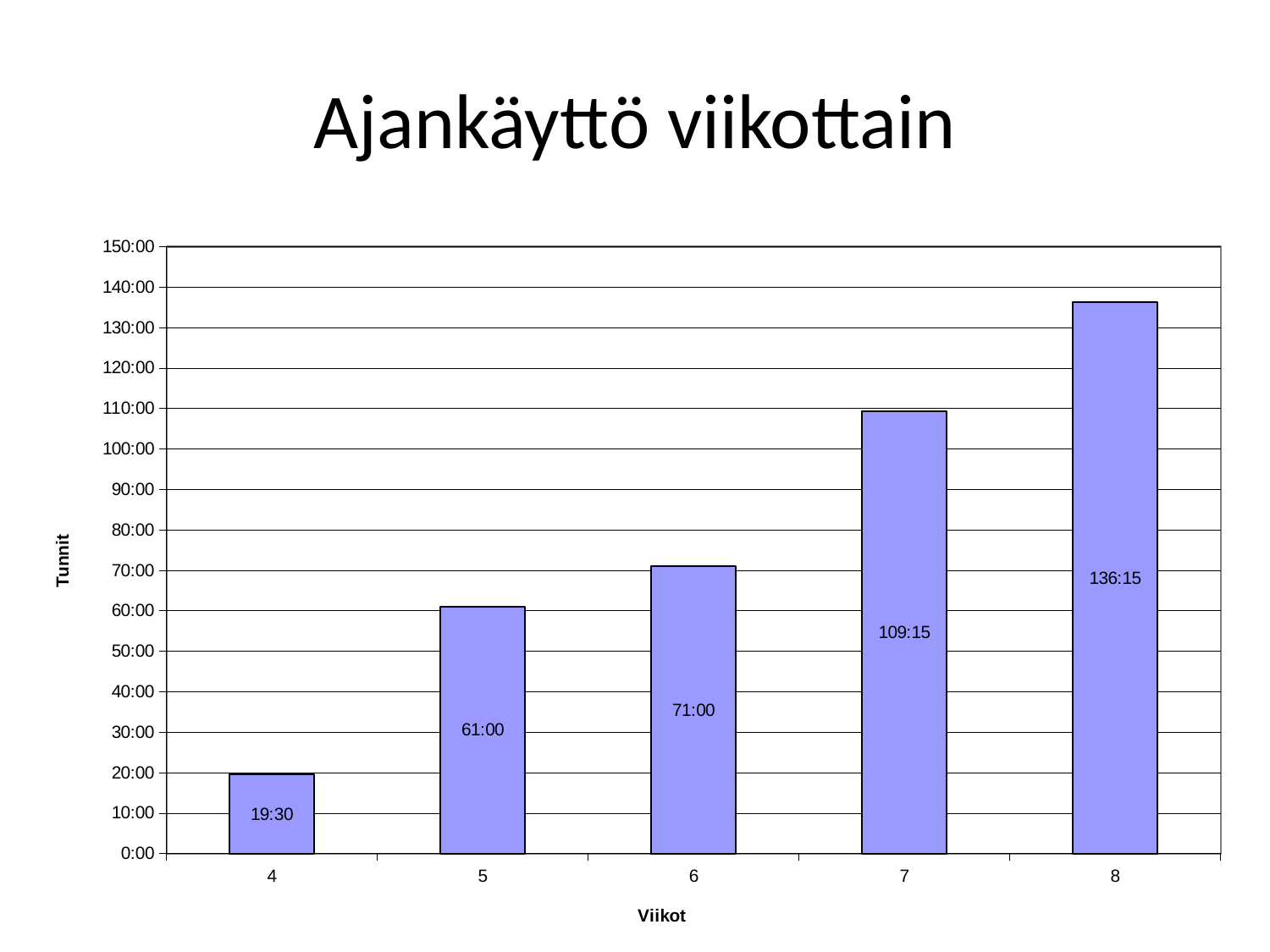
Do the values rise or fall from week 4 to week 8? rise What is the value for week 7? 109:15 Which week has the highest value? 8 Which is larger, the value for week 5 or the value for week 6? week 6 What is the difference between the values for week 8 and week 7? 27:00 What kind of chart is shown on the slide? bar chart What is the difference between the values for week 6 and week 5? 10:00 What is the value for week 6? 71:00 Which week has the lowest value? 4 Is the value for week 7 greater or less than 100:00? greater What is the value for week 4? 19:30 How many weeks are shown on the x axis? 5